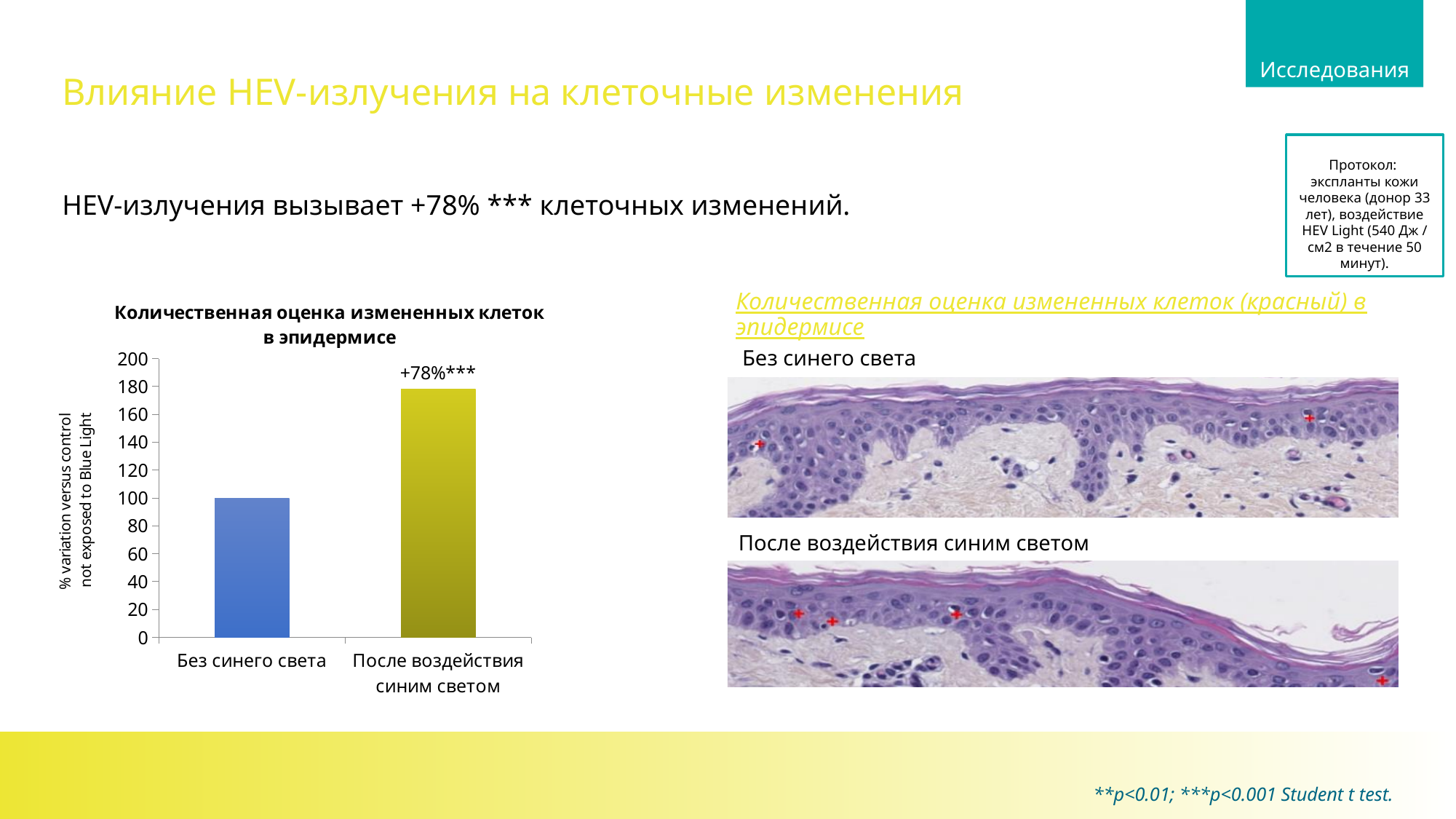
Which category has the lowest bar in the chart? Без синего света What data label is printed above the bar for После воздействия синим светом? +78%*** Which is larger: the bar for Без синего света or the bar for После воздействия синим светом? После воздействия синим светом What is the maximum value shown on the y axis of the bar chart? 200 What kind of chart is shown on the slide? bar chart How many categories are plotted in the bar chart? 2 Do the values rise or fall from left to right along the x axis? rise What is the value for Без синего света in the bar chart? 100 Is the value for После воздействия синим светом greater or less than 160? greater What is the title of the bar chart? Количественная оценка измененных клеток в эпидермисе Which category has the highest bar in the chart? После воздействия синим светом